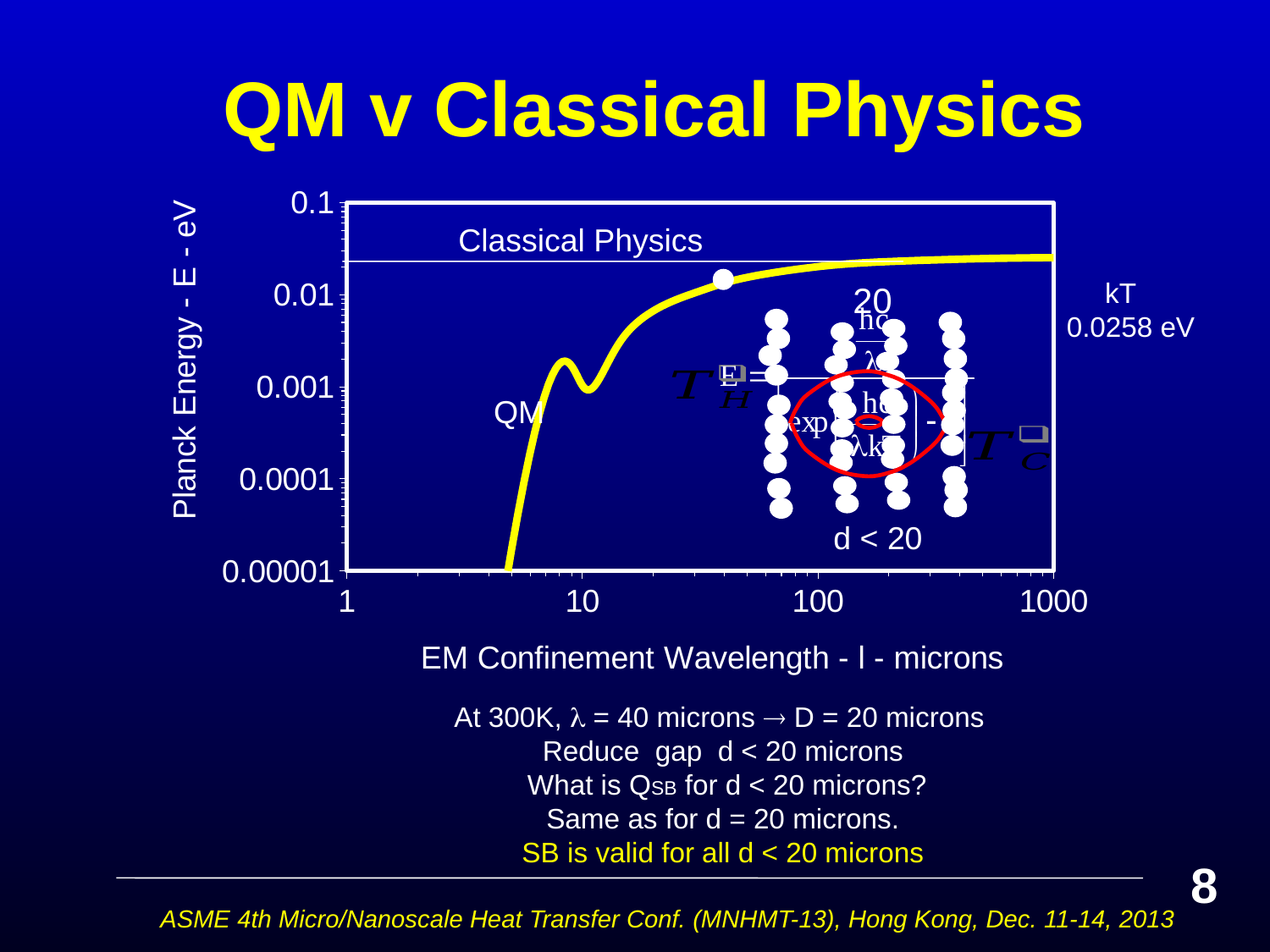
What is the highest value shown on the x axis? 1000 At what wavelength is the white dot on the QM curve placed, according to the slide text? 40 microns Is the QM curve value at 100 microns greater or less than 0.01? greater What is the lowest value shown on the y axis? 0.00001 Is the QM curve value at 1000 microns greater or less than 0.1? less Is the QM curve value at 5 microns greater or less than 0.0001? less Does the QM curve rise or fall as the EM confinement wavelength increases from 1 to 1000 microns? rise What is the title of the slide containing the chart? QM v Classical Physics What kind of chart is shown on the slide? line chart What value of kT does the Classical Physics line correspond to? 0.0258 eV At 10 microns, which is larger: the QM curve or the Classical Physics line? Classical Physics line What is the label of the y axis of the chart? Planck Energy - E - eV